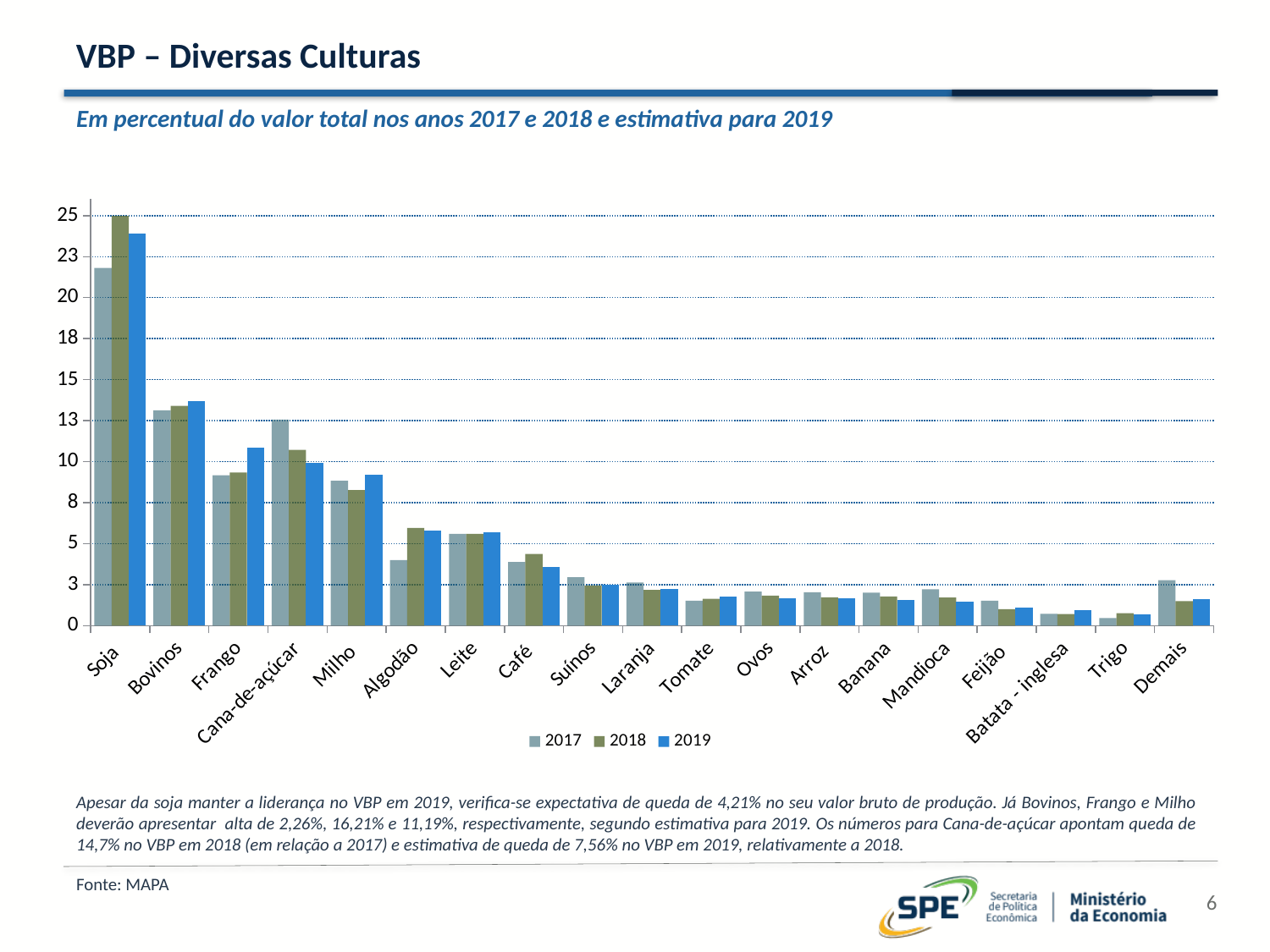
Do the values for Cana-de-açúcar rise or fall from 2017 to 2019? fall Is the 2019 value for Frango greater or less than 10? greater Which category has the highest value for 2019? Soja What kind of chart is shown on the slide? bar chart How many series does the legend list? 3 Is the 2017 value for Algodão greater or less than 5? less Is the 2018 value for Milho greater or less than 10? less For Soja, which is larger: the 2017 value or the 2018 value? 2018 What are the entries in the chart legend? 2017, 2018, 2019 How many categories are shown on the x axis? 19 Which category has the lowest value for 2017? Trigo